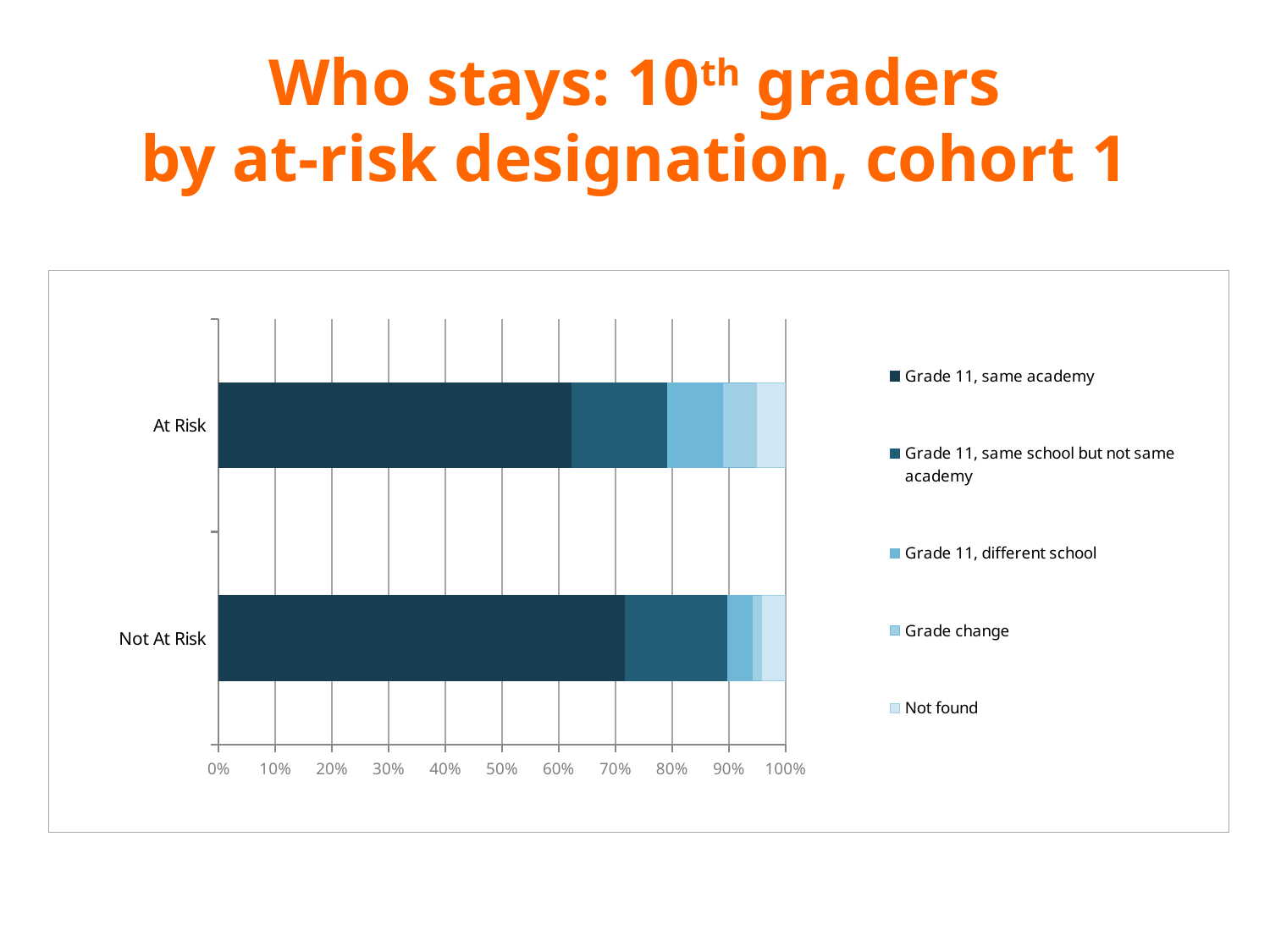
What is the title of the slide containing the chart? Who stays: 10th graders by at-risk designation, cohort 1 What kind of chart is shown on the slide? Stacked bar chart Which category has the larger 'Grade 11, same academy' share, At Risk or Not At Risk? Not At Risk Is the 'Grade 11, same academy' share for At Risk greater or less than 50%? greater Which series makes up the largest portion of the At Risk bar? Grade 11, same academy Which category has the larger 'Grade change' share, At Risk or Not At Risk? At Risk Is the 'Grade 11, same academy' share for Not At Risk greater or less than 60%? greater Which legend entry is listed first in the chart's legend? Grade 11, same academy Which category has the larger 'Grade 11, different school' share, At Risk or Not At Risk? At Risk How many categories are plotted on the vertical axis of the chart? 2 What is the highest value shown on the horizontal axis of the chart? 100% How many series does the chart's legend list? 5